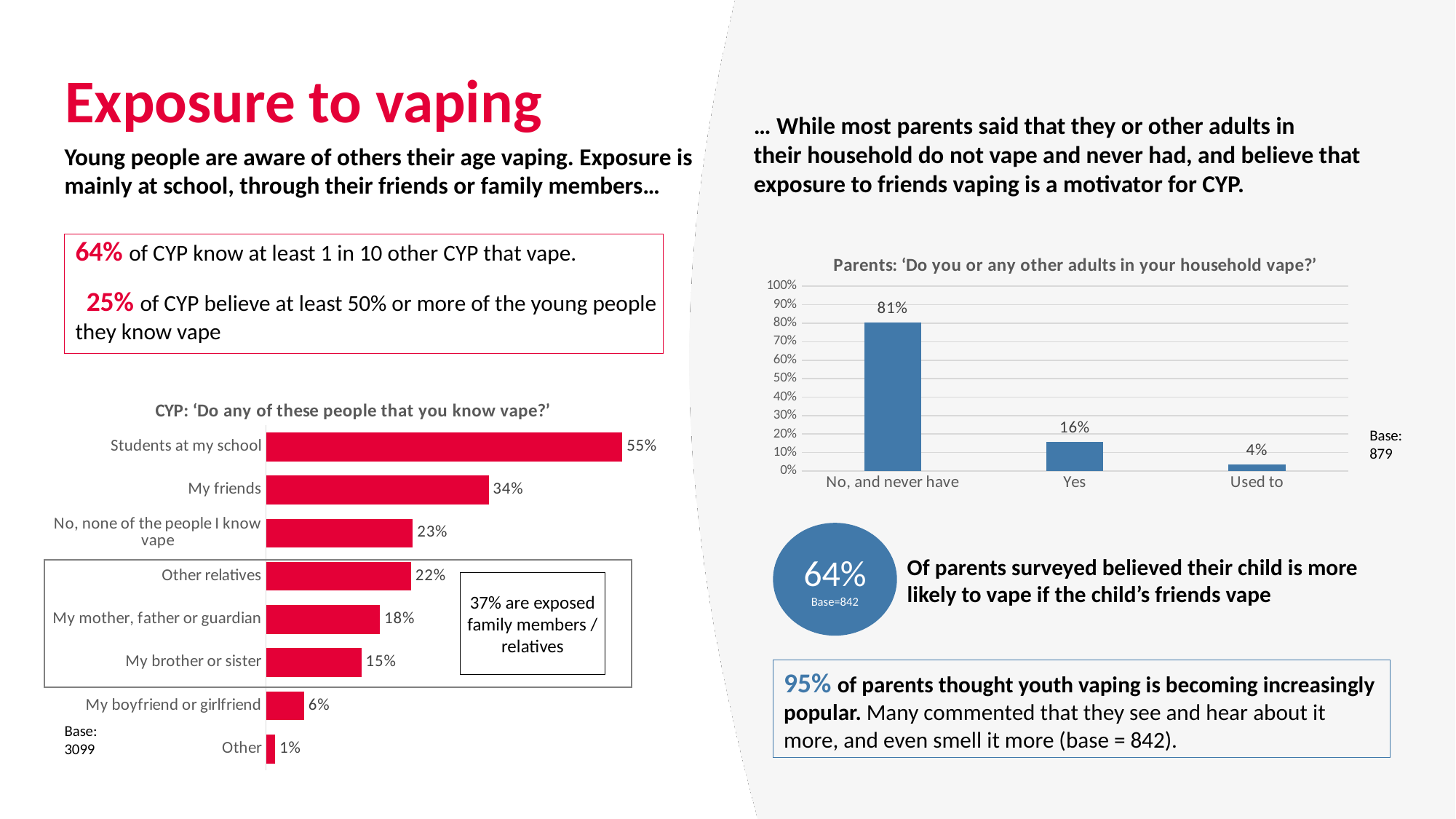
What kind of chart is 'CYP: Do any of these people that you know vape?'? Bar chart In the chart 'Parents: Do you or any other adults in your household vape?', which category has the highest value? No, and never have In the chart 'CYP: Do any of these people that you know vape?', which category has the highest value? Students at my school In the chart 'CYP: Do any of these people that you know vape?', what is the difference between 'Students at my school' and 'My friends'? 21% In the chart 'CYP: Do any of these people that you know vape?', how many categories are shown? 8 In the chart 'Parents: Do you or any other adults in your household vape?', what is the difference between 'Yes' and 'Used to'? 12% In the chart 'CYP: Do any of these people that you know vape?', which category has the lowest value? Other In the chart 'Parents: Do you or any other adults in your household vape?', how many categories are shown? 3 In the chart 'CYP: Do any of these people that you know vape?', what is the value for 'My friends'? 34% In the chart 'Parents: Do you or any other adults in your household vape?', what is the value for 'Yes'? 16% In the chart 'CYP: Do any of these people that you know vape?', what is the value for 'My brother or sister'? 15% In the chart 'CYP: Do any of these people that you know vape?', which is larger: 'Other relatives' or 'My mother, father or guardian'? Other relatives